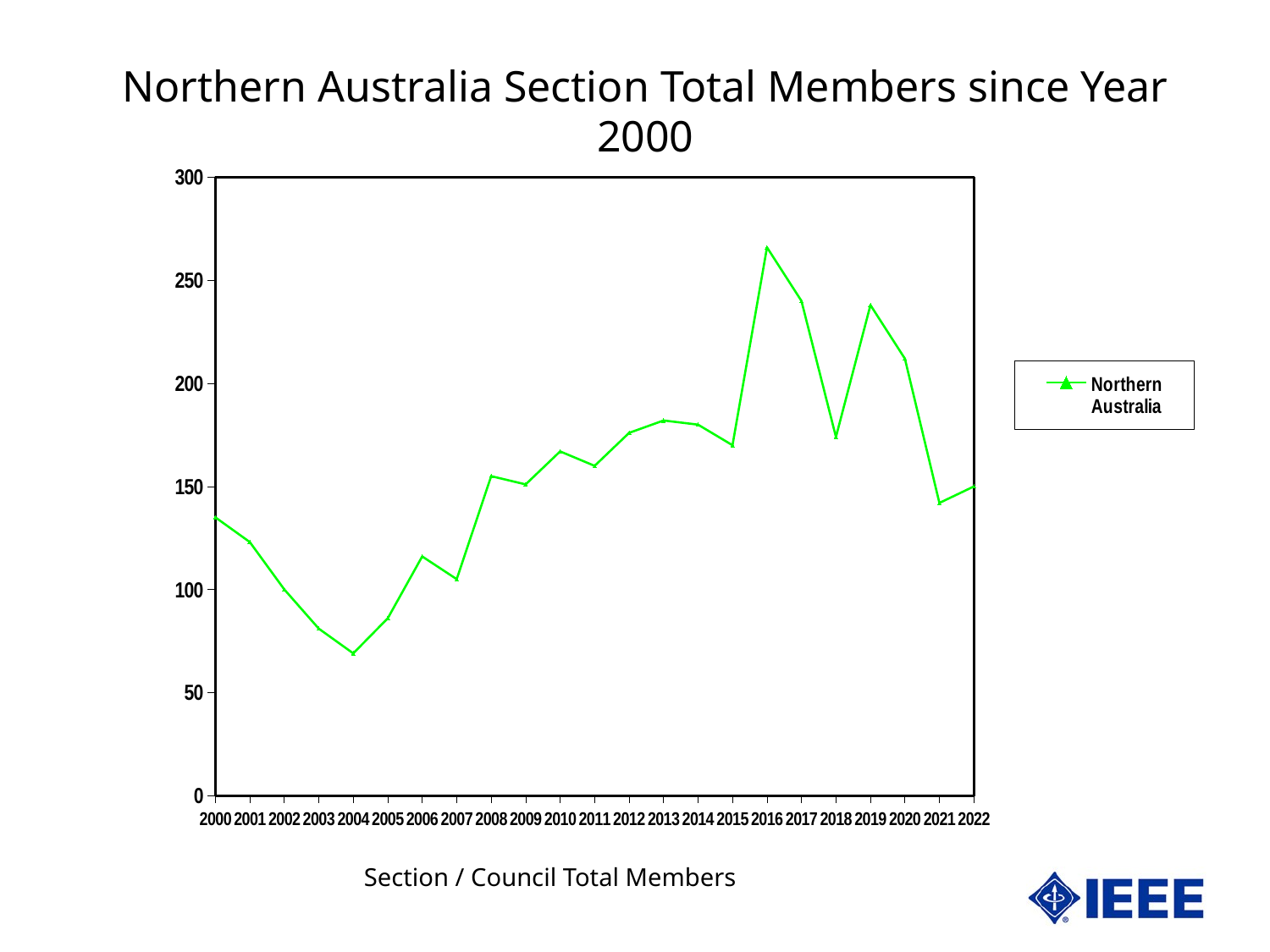
Do the values rise or fall from 2000 to 2004? fall In which year is the number of Northern Australia members lowest? 2004 In which year is the number of Northern Australia members highest? 2016 How many series does the legend list? 1 What is the name of the series shown in the legend? Northern Australia Which year has more members, 2016 or 2019? 2016 How many years are plotted along the x axis? 23 What kind of chart is shown on the slide? line chart Is the value for 2013 greater or less than 150? greater Is the value for 2016 greater or less than 250? greater Is the value for 2000 greater or less than 100? greater